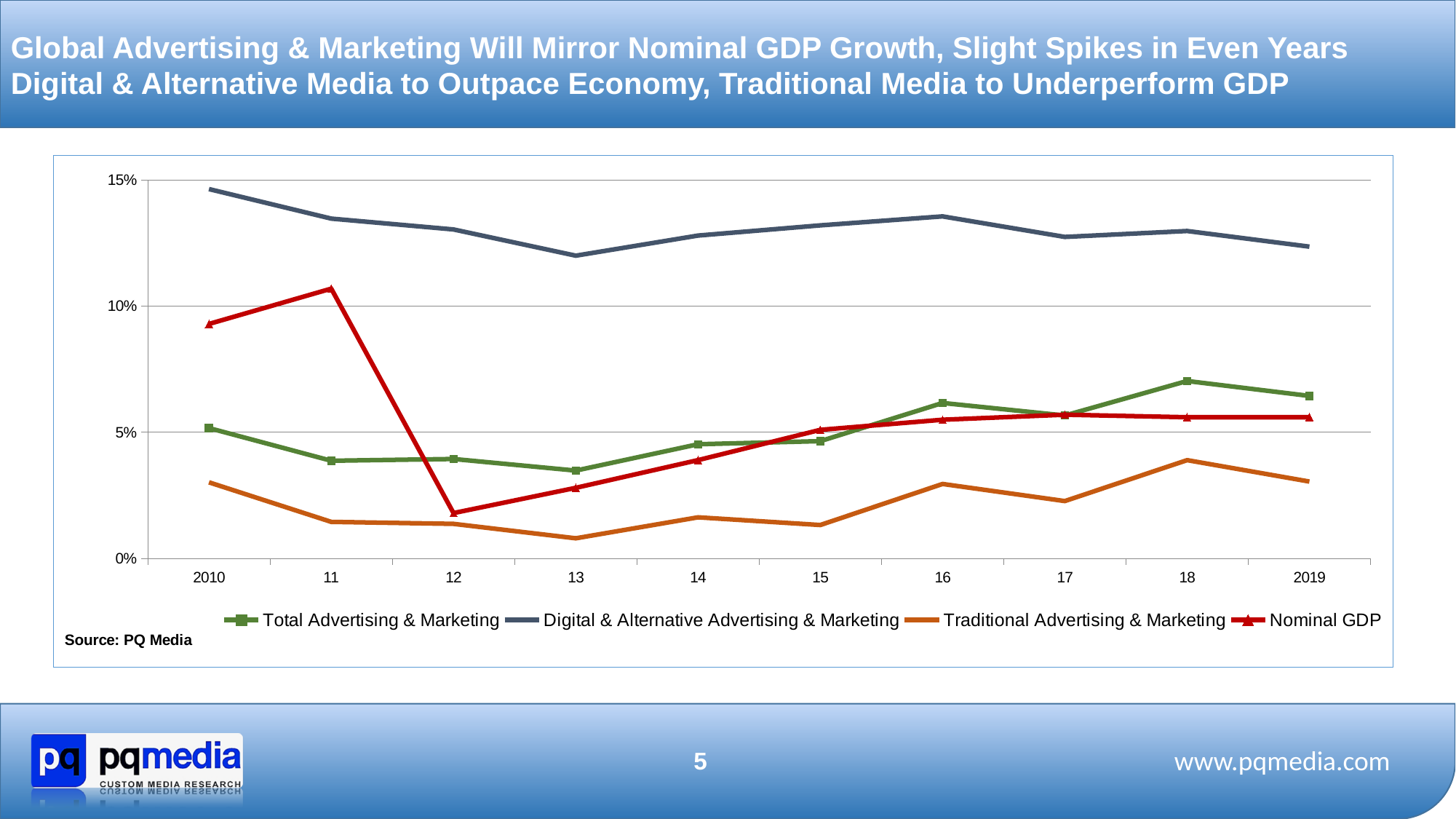
Does Nominal GDP rise or fall from 2011 to 2012? fall How many series does the legend list? 4 Is the value for Nominal GDP in 2012 greater or less than 5%? less How many years are plotted along the x axis? 10 Which series has the lowest value in 2013? Traditional Advertising & Marketing What kind of chart is shown on the slide? line chart In 2018, which is higher: Total Advertising & Marketing or Nominal GDP? Total Advertising & Marketing Which series has the highest value in 2019? Digital & Alternative Advertising & Marketing In 2010, which is higher: Nominal GDP or Total Advertising & Marketing? Nominal GDP In which year does Nominal GDP reach its highest value? 2011 Is the value for Traditional Advertising & Marketing in 2018 greater or less than 5%? less Is the value for Digital & Alternative Advertising & Marketing in 2010 greater or less than 10%? greater